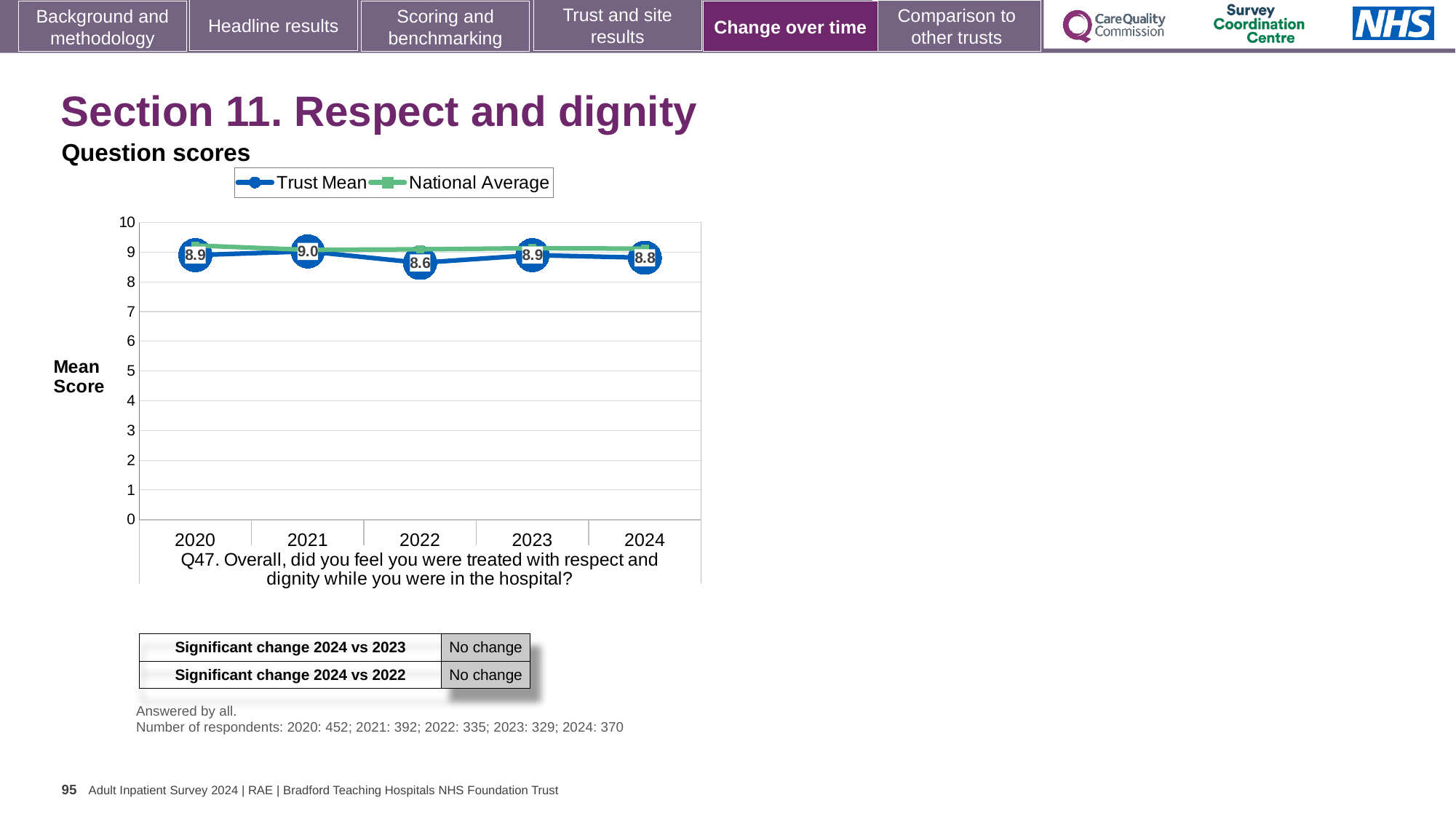
What kind of chart is shown? Line chart Is the National Average value for 2022 greater or less than 8? greater In which year was the Trust Mean score lowest? 2022 What is the Trust Mean score for 2021? 9.0 How many years are plotted on the x axis? 5 In which year was the Trust Mean score highest? 2021 Which is larger, the Trust Mean score for 2023 or for 2024? 2023 Did the Trust Mean score rise or fall from 2021 to 2022? Fall What is the difference between the Trust Mean scores for 2021 and 2022? 0.4 What is the Trust Mean score for 2022? 8.6 What is the Trust Mean score for 2024? 8.8 How many series does the legend list? 2